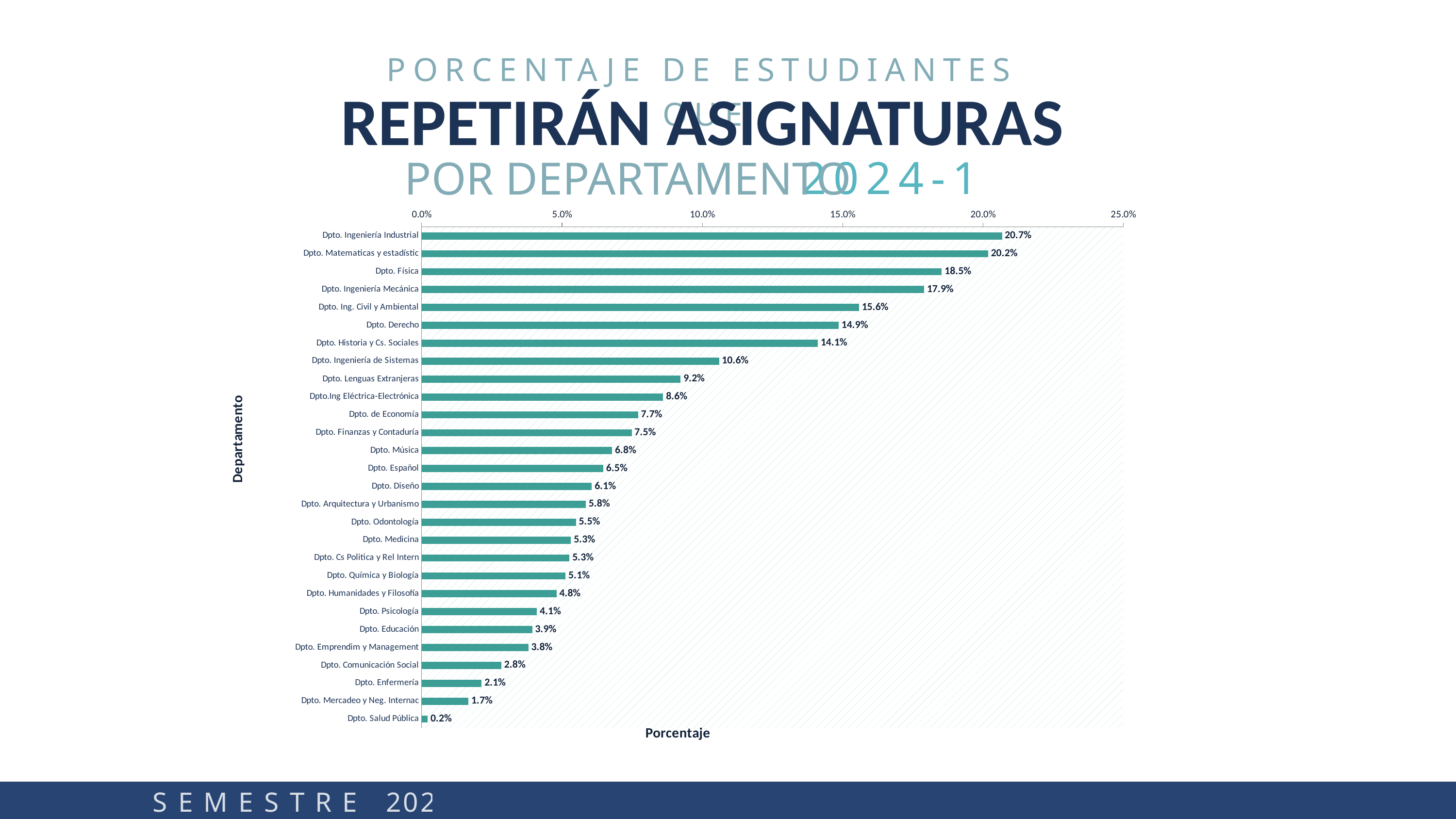
What is the value for Dpto. Música? 6.8% What is the value for Dpto. Ingeniería Industrial? 20.7% Which department has the highest percentage? Dpto. Ingeniería Industrial What is the difference between the values for Dpto. Física and Dpto. Ingeniería Mecánica? 0.6% Is the value for Dpto. Ing. Civil y Ambiental greater or less than 15.0%? greater How many departments are shown in the chart? 28 Which is larger, the value for Dpto. Psicología or the value for Dpto. Enfermería? Dpto. Psicología What is the difference between the values for Dpto. Ingeniería de Sistemas and Dpto. Lenguas Extranjeras? 1.4% What is the label of the horizontal axis? Porcentaje Which department has the lowest percentage? Dpto. Salud Pública What kind of chart is shown on the slide? bar chart What is the value for Dpto. Derecho? 14.9%